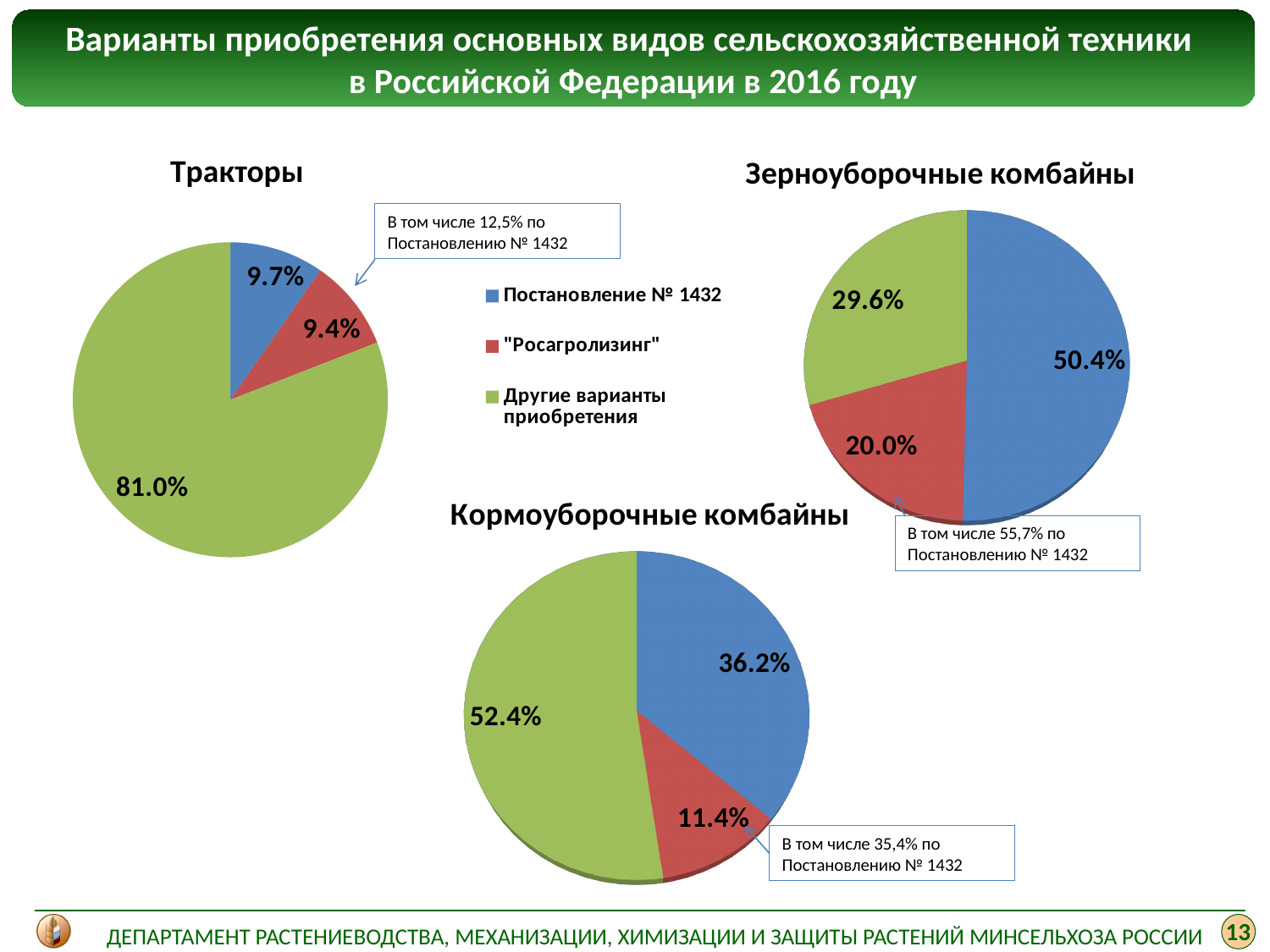
Which colour represents '"Росагролизинг"' in the legend? Red In the 'Зерноуборочные комбайны' pie chart, what is the difference between the shares for 'Постановление № 1432' and 'Другие варианты приобретения'? 20.8% In the 'Тракторы' pie chart, what share is labelled for 'Другие варианты приобретения'? 81.0% In the 'Кормоуборочные комбайны' pie chart, which category has the smallest share? "Росагролизинг" How many slices does the 'Тракторы' pie chart have? 3 What type of chart is used for 'Зерноуборочные комбайны'? Pie chart In the 'Тракторы' pie chart, what share is labelled for 'Постановление № 1432'? 9.7% In the 'Зерноуборочные комбайны' pie chart, what share is labelled for '"Росагролизинг"'? 20.0% In the 'Зерноуборочные комбайны' pie chart, which category has the largest share? Постановление № 1432 In the 'Кормоуборочные комбайны' pie chart, what share is labelled for 'Постановление № 1432'? 36.2% In the 'Кормоуборочные комбайны' pie chart, which is larger: the share for 'Другие варианты приобретения' or the share for 'Постановление № 1432'? Другие варианты приобретения How many entries does the legend list? 3